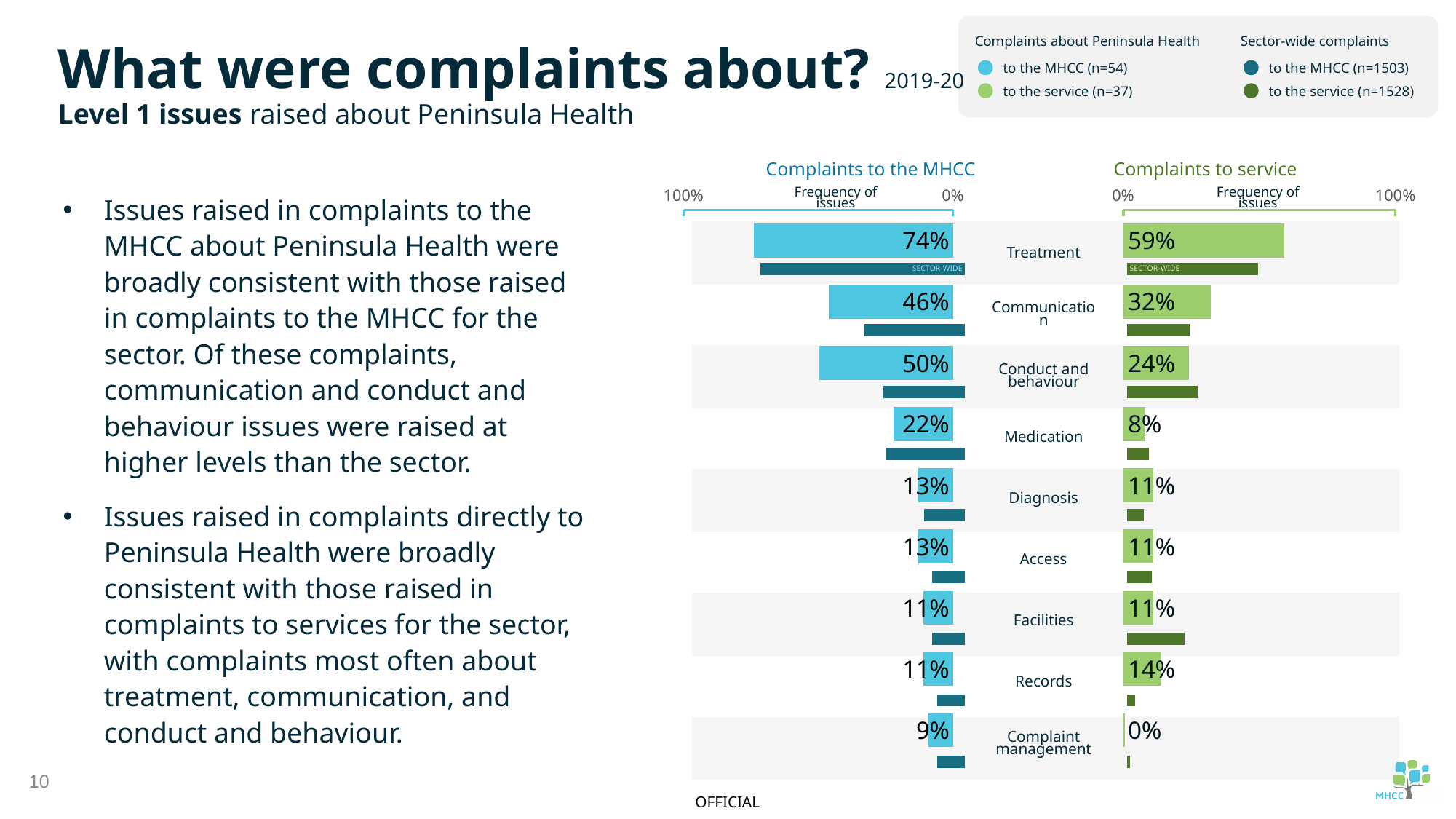
In the Complaints to the MHCC chart, is the sector-wide bar for Treatment greater or less than 50%? greater In the Complaints to service chart, which issue has the lowest frequency? Complaint management In the Complaints to service chart, what is the value for Records? 14% How many issue categories are shown in the Complaints to service chart? 9 What kind of chart is the Complaints to the MHCC chart? Bar chart In the Complaints to the MHCC chart, which issue has the highest frequency? Treatment In the Complaints to the MHCC chart, what is the frequency of issues for Treatment? 74% In the Complaints to service chart, what is the frequency of issues for Communication? 32% In the Complaints to the MHCC chart, which is larger: Communication or Conduct and behaviour? Conduct and behaviour What is the difference between the Treatment value in the Complaints to the MHCC chart and the Treatment value in the Complaints to service chart? 15 percentage points In the Complaints to the MHCC chart, what is the difference between the Treatment and Communication values? 28 percentage points According to the legend, how many complaints about Peninsula Health were made to the MHCC? n=54